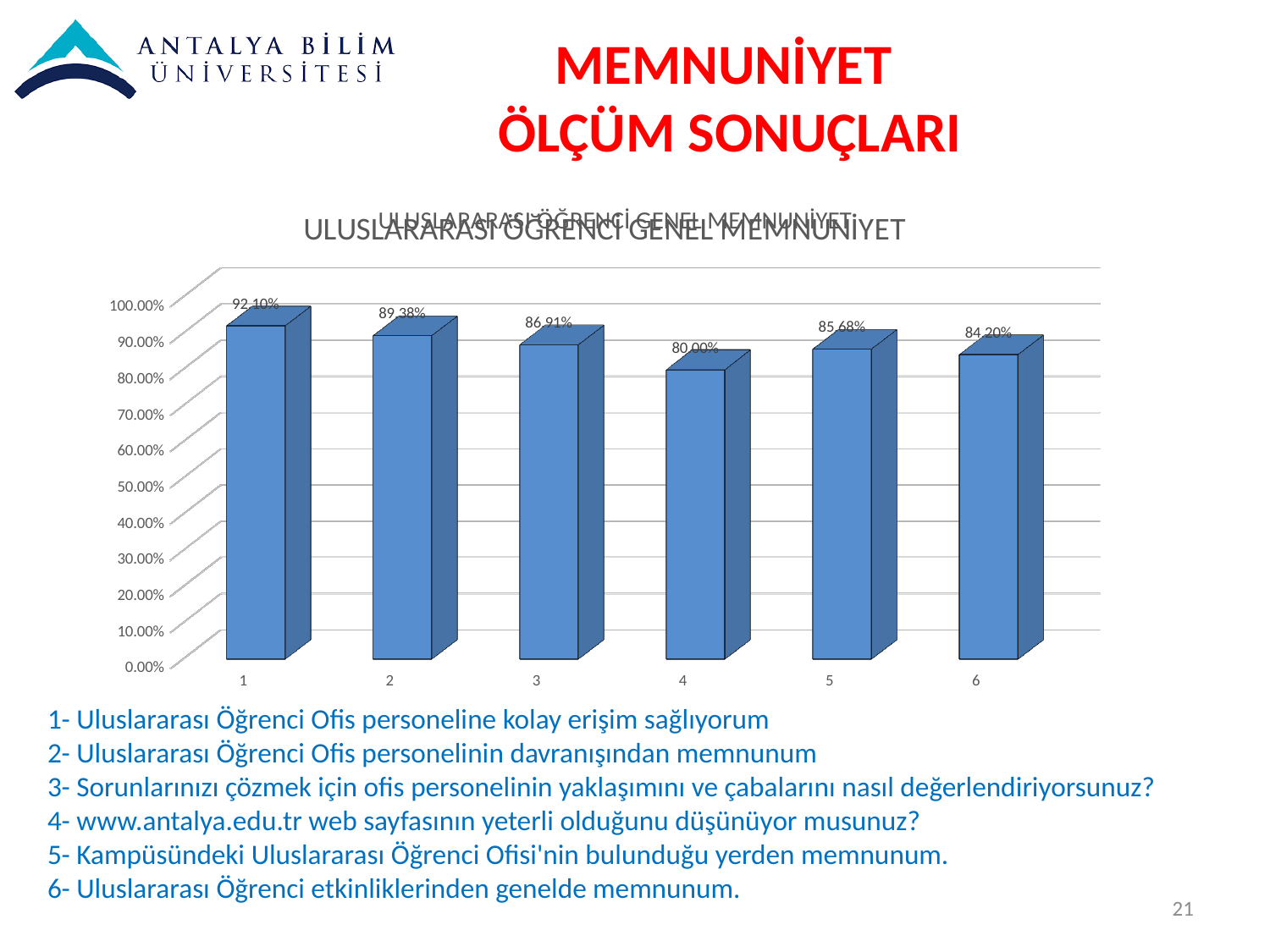
Is the value for category 3 greater or less than 80.00%? greater What is the difference between the values for category 2 and category 3? 2.47% What is the value for category 6? 84.20% Which category has the lowest value? 4 Which is larger, the value for category 5 or the value for category 6? category 5 Which category has the highest value? 1 How many categories are shown on the x axis? 6 What is the value for category 1? 92.10% What is the value for category 4? 80.00% What is the title of the chart? ULUSLARARASI ÖĞRENCİ GENEL MEMNUNİYET What is the difference between the values for category 1 and category 4? 12.10% What kind of chart is shown on the slide? bar chart